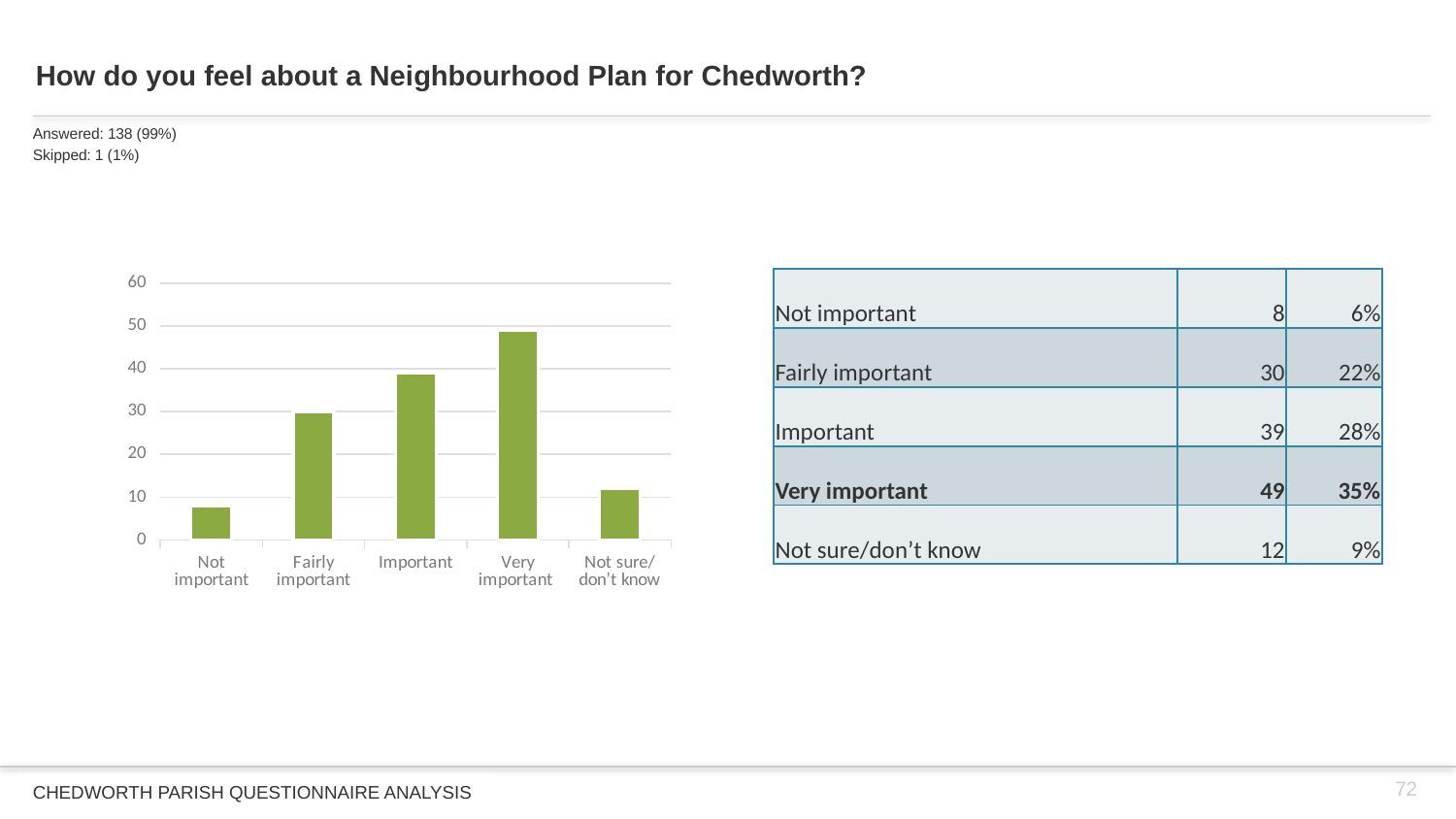
Which is larger, the value for Important or the value for Fairly important? Important Which category has the highest bar in the chart? Very important What is the highest value shown on the chart's vertical axis? 60 According to the table on the slide, how many respondents answered Very important? 49 Using the values in the table, what is the difference between the Very important and Important counts? 10 According to the table on the slide, what percentage of respondents answered Not sure/don't know? 9% Which category has the lowest bar in the chart? Not important Is the value for Not important greater or less than 10? less Is the value for Fairly important greater or less than 20? greater How many categories does the bar chart show? 5 What kind of chart is shown on the slide? bar chart Is the value for Very important greater or less than 40? greater